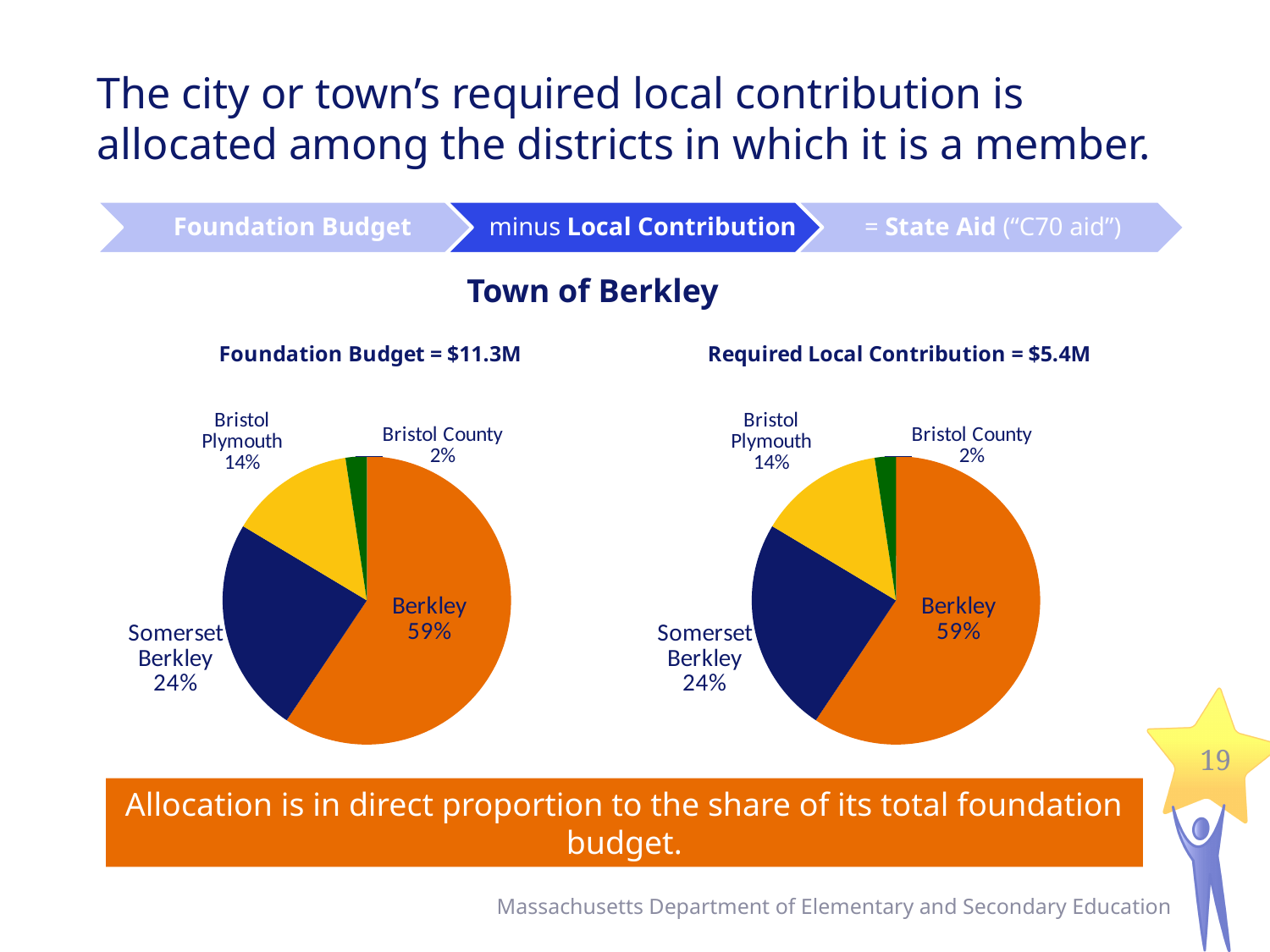
What colour is the Somerset Berkley slice in the 'Required Local Contribution = $5.4M' pie chart? Dark blue In the 'Foundation Budget = $11.3M' pie chart, what is the difference in percentage points between Berkley and Somerset Berkley? 35 What type of chart is used for 'Required Local Contribution = $5.4M'? Pie chart In the 'Required Local Contribution = $5.4M' pie chart, which is larger, Bristol Plymouth or Somerset Berkley? Somerset Berkley In the 'Required Local Contribution = $5.4M' pie chart, which district has the smallest slice? Bristol County In the 'Foundation Budget = $11.3M' pie chart, what share does Berkley have? 59% In the 'Required Local Contribution = $5.4M' pie chart, what share does Bristol County have? 2% In the 'Foundation Budget = $11.3M' pie chart, which district has the largest slice? Berkley In the 'Foundation Budget = $11.3M' pie chart, what is the combined share of Bristol Plymouth and Bristol County? 16% How many slices does the 'Foundation Budget = $11.3M' pie chart have? 4 In the 'Required Local Contribution = $5.4M' pie chart, what share does Somerset Berkley have? 24%